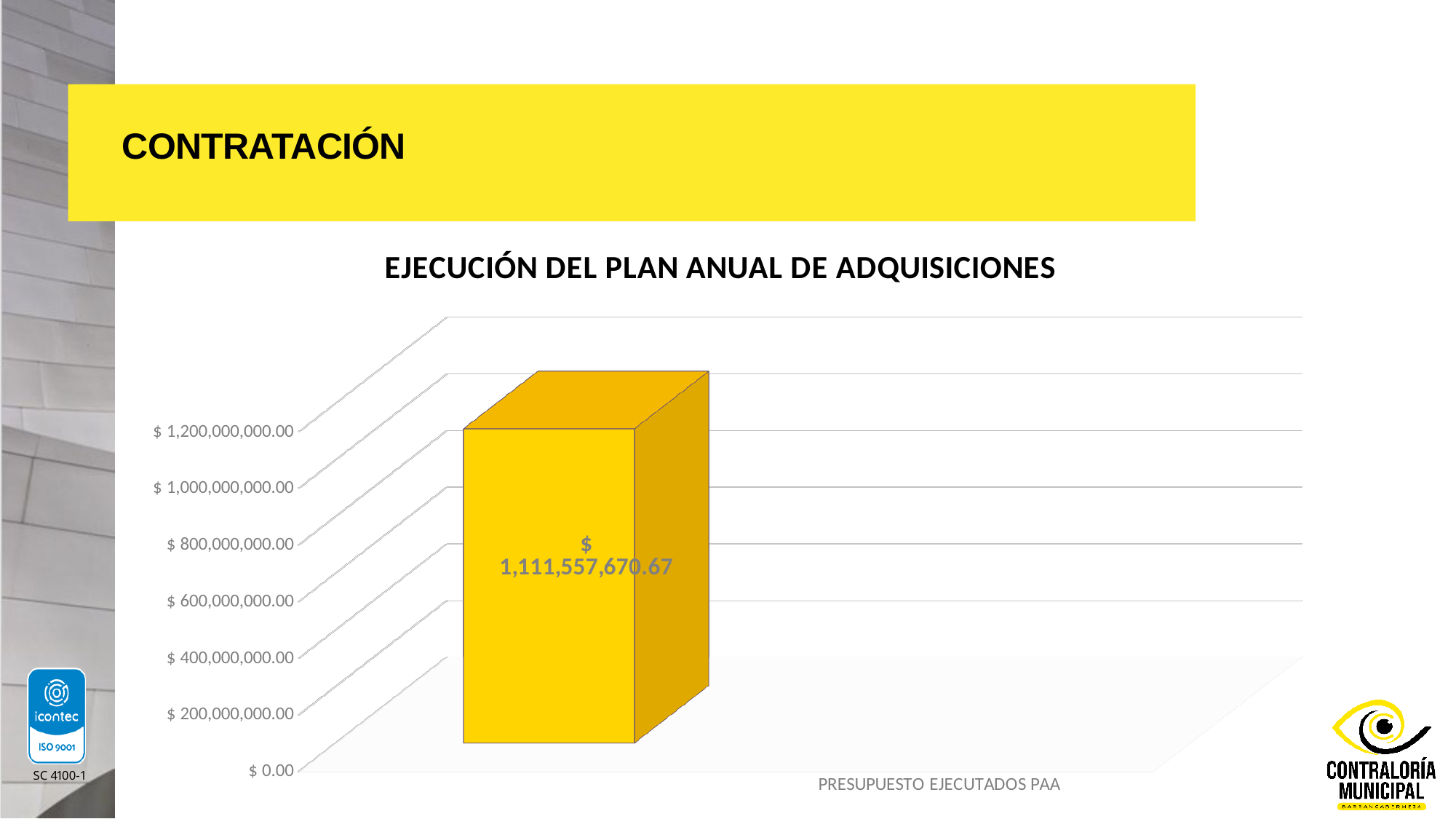
What is the value shown for PRESUPUESTO EJECUTADOS PAA? $ 1,111,557,670.67 What is the title of the chart? EJECUCIÓN DEL PLAN ANUAL DE ADQUISICIONES Is the value for PRESUPUESTO EJECUTADOS PAA greater or less than $ 1,000,000,000.00? greater What is the highest value labelled on the vertical axis of the chart? $ 1,200,000,000.00 What is the category label shown on the x axis of the chart? PRESUPUESTO EJECUTADOS PAA How many bars are plotted in the chart? 1 What kind of chart is shown on the slide? bar chart Is the value for PRESUPUESTO EJECUTADOS PAA greater or less than $ 1,200,000,000.00? less